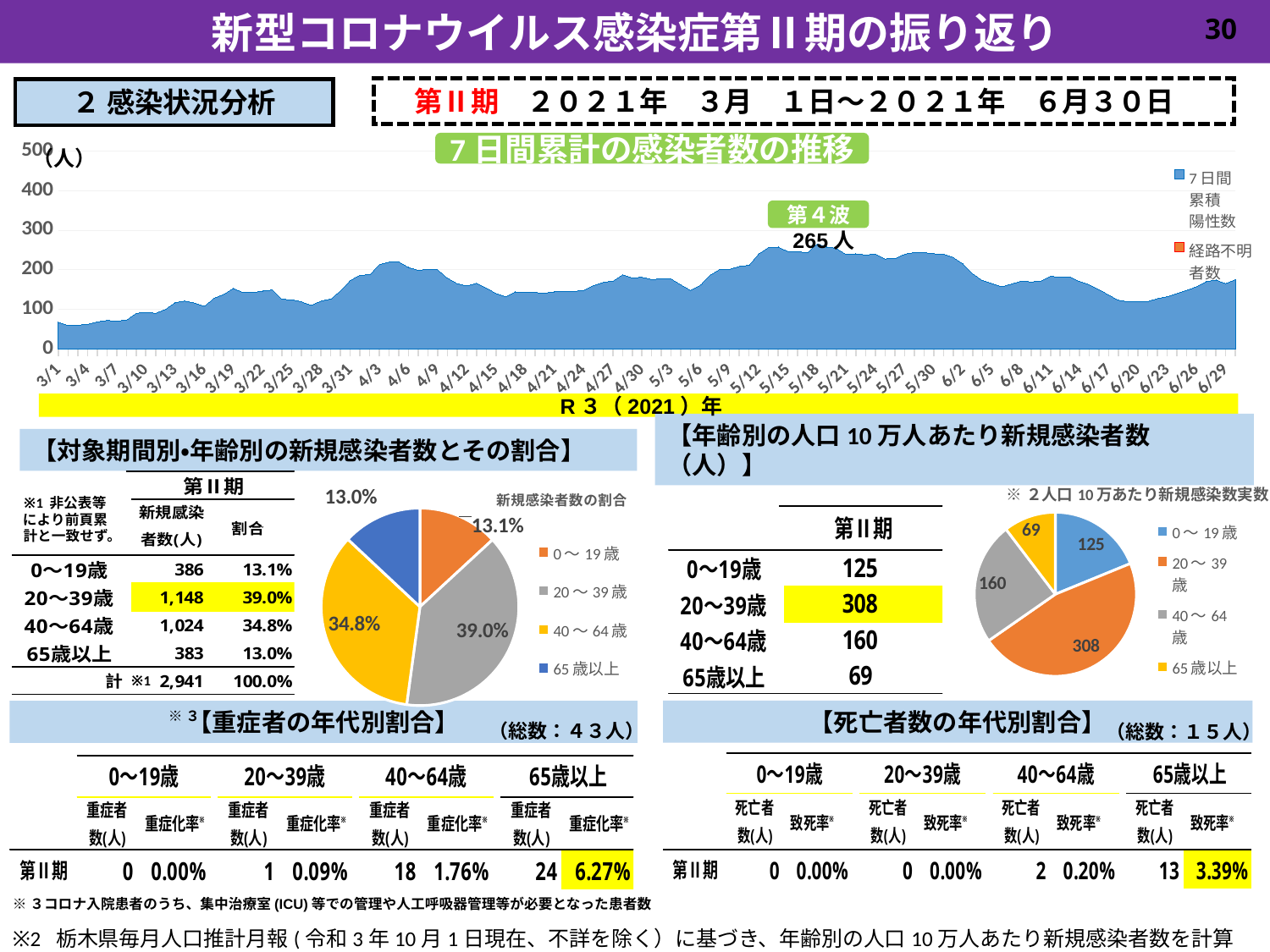
In the pie chart 年齢別の人口10万人あたり新規感染者数, what is the value for 40〜64歳? 160 In the pie chart 新規感染者数の割合, what is the difference between the shares of 20〜39歳 and 40〜64歳? 4.2 percentage points In the pie chart 年齢別の人口10万人あたり新規感染者数, which is larger, the value for 0〜19歳 or for 40〜64歳? 40〜64歳 In the pie chart 新規感染者数の割合, what is the share for 20〜39歳? 39.0% In the top chart 7日間累計の感染者数の推移, is the value on 6/20 greater or less than 200? less What type of chart is the top chart titled 7日間累計の感染者数の推移? area chart In the pie chart 新規感染者数の割合, which age group has the largest share? 20〜39歳 How many series does the legend of the top chart 7日間累計の感染者数の推移 list? 2 In the top chart 7日間累計の感染者数の推移, is the value on 3/1 greater or less than 100? less How many slices does the pie chart 新規感染者数の割合 have? 4 In the top chart 7日間累計の感染者数の推移, what value is labelled at the 第4波 peak? 265人 In the pie chart 年齢別の人口10万人あたり新規感染者数, which age group has the lowest value? 65歳以上